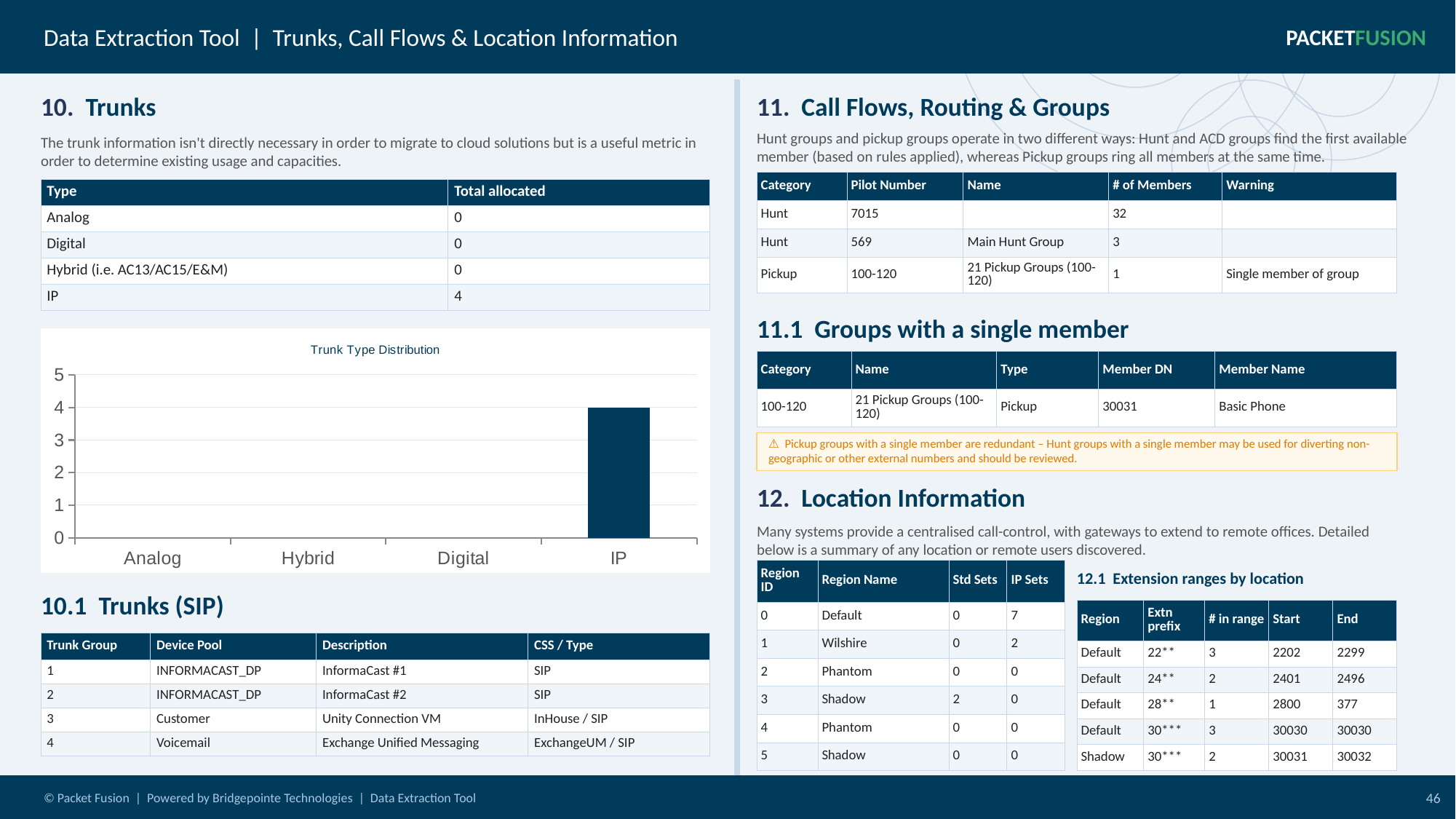
What kind of chart is the Trunk Type Distribution chart? bar chart In the Trunk Type Distribution chart, what is the value for IP? 4 In the Trunk Type Distribution chart, is the value for IP greater or less than 3? greater In the Trunk Type Distribution chart, which category has the highest value? IP In the Trunk Type Distribution chart, what is the difference between the value for IP and the value for Analog? 4 In the Trunk Type Distribution chart, what is the value for Digital? 0 What is the title of the chart on the slide? Trunk Type Distribution In the Trunk Type Distribution chart, what is the value for Hybrid? 0 How many categories are shown on the x axis of the Trunk Type Distribution chart? 4 In the Trunk Type Distribution chart, which is larger, the value for IP or the value for Digital? IP In the Trunk Type Distribution chart, what is the value for Analog? 0 What is the highest value shown on the y axis of the Trunk Type Distribution chart? 5